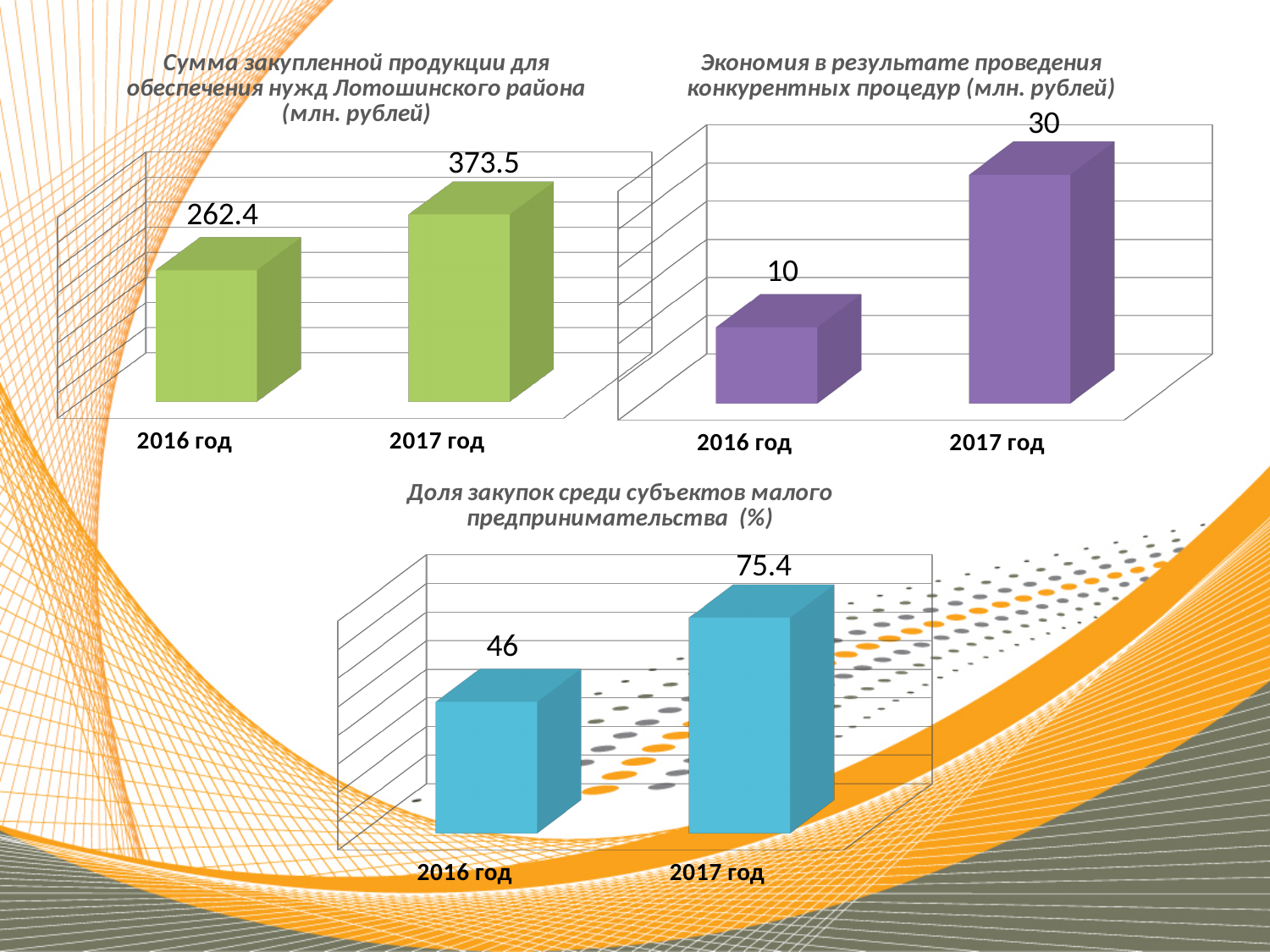
In the top-right chart (Экономия), what is the difference between the 2017 год and 2016 год values? 20 In the top-right chart (Экономия в результате проведения конкурентных процедур), what is the value for 2016 год? 10 In the top-left chart (Сумма закупленной продукции для обеспечения нужд Лотошинского района), what is the value for 2017 год? 373.5 In the top-right chart (Экономия в результате проведения конкурентных процедур), what is the value for 2017 год? 30 In the top-left chart (Сумма закупленной продукции для обеспечения нужд Лотошинского района), what is the value for 2016 год? 262.4 What kind of chart is the top-left chart (Сумма закупленной продукции)? bar chart In the bottom chart (Доля закупок среди субъектов малого предпринимательства), which year has the lowest value? 2016 год In the bottom chart (Доля закупок среди субъектов малого предпринимательства), what is the value for 2016 год? 46 In the top-right chart (Экономия в результате проведения конкурентных процедур), which year has the highest value? 2017 год In the top-left chart (Сумма закупленной продукции), what is the difference between the 2017 год and 2016 год values? 111.1 In the bottom chart (Доля закупок), do the values rise or fall from 2016 год to 2017 год? rise In the bottom chart (Доля закупок среди субъектов малого предпринимательства), what is the value for 2017 год? 75.4